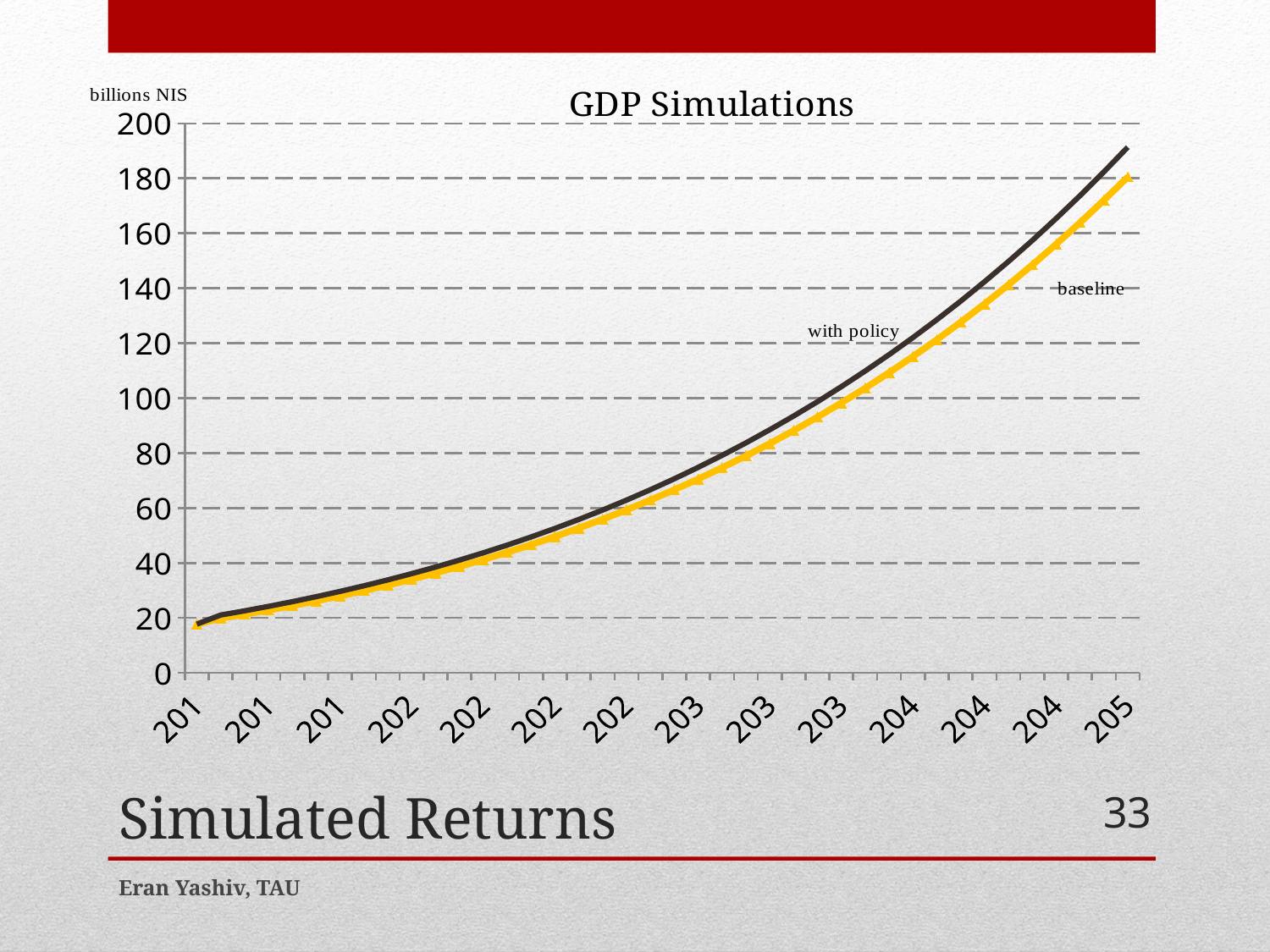
How many series are plotted in the GDP Simulations chart? 2 Is the final value of the 'baseline' series greater or less than 160? greater What unit is shown for the vertical axis of the chart? billions NIS Is the starting value of the 'baseline' series greater or less than 40? less Is the starting value of the 'with policy' series greater or less than 60? less What is the maximum value shown on the vertical axis of the chart? 200 At the right end of the chart, which series is higher: 'with policy' or 'baseline'? with policy Do the values of the 'with policy' series rise or fall along the x axis? rise What kind of chart is shown on the slide? line chart Do the values of the 'baseline' series rise or fall along the x axis? rise What is the title of the chart? GDP Simulations